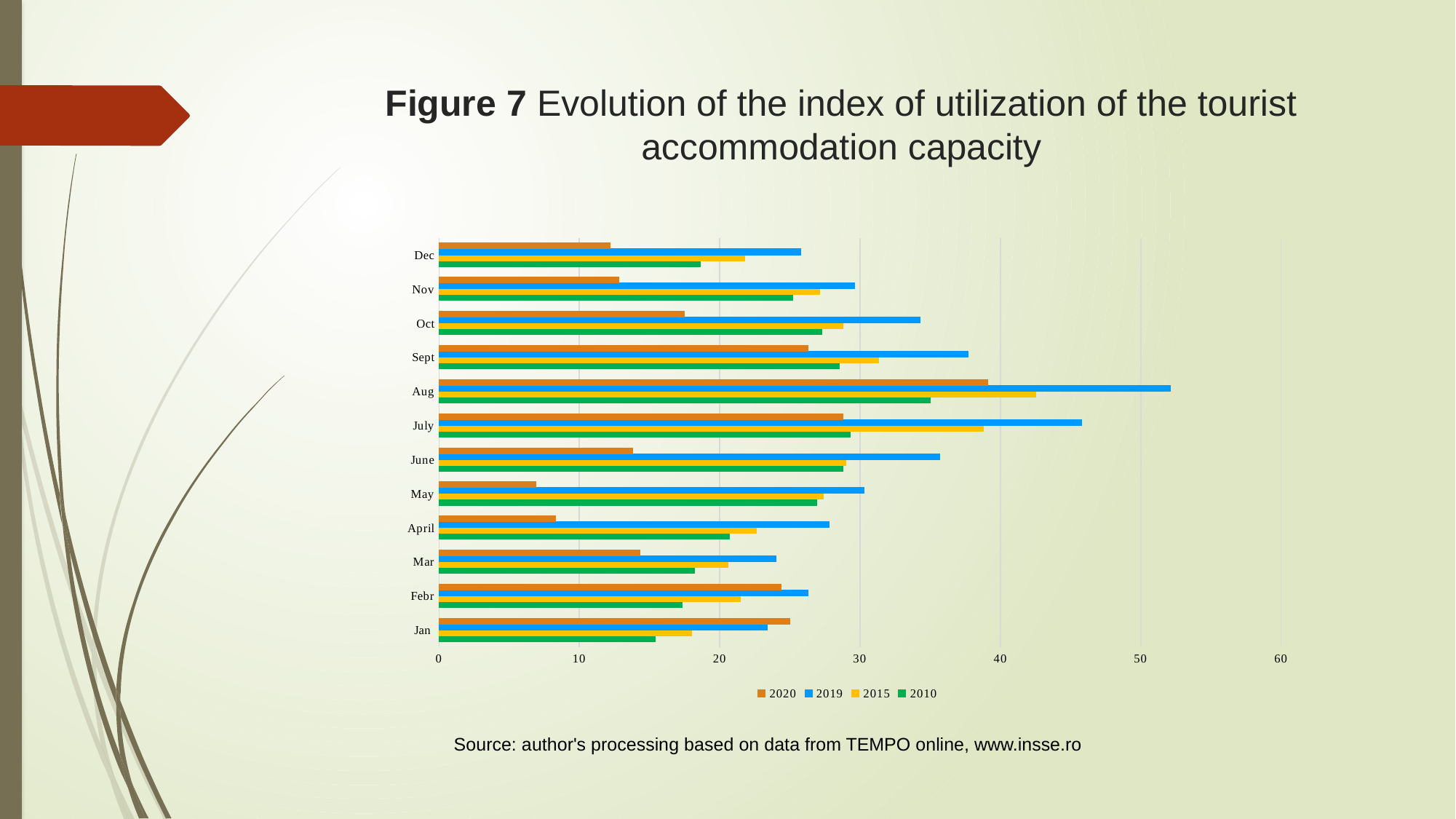
What is the figure number given in the slide title? Figure 7 Which month has the lowest value for the 2020 series? May Which month has the highest value for the 2019 series? Aug What kind of chart is shown on the slide? bar chart Which years are listed in the chart legend? 2020, 2019, 2015, 2010 Is the 2019 value for July greater or less than 40? greater For the 2020 series, which month has the larger value, Sept or Oct? Sept How many months (categories) are plotted on the chart? 12 Is the 2020 value for May greater or less than 10? less Is the 2019 value for Aug greater or less than 50? greater For Aug, which series has the larger value, 2019 or 2015? 2019 How many series does the legend list? 4